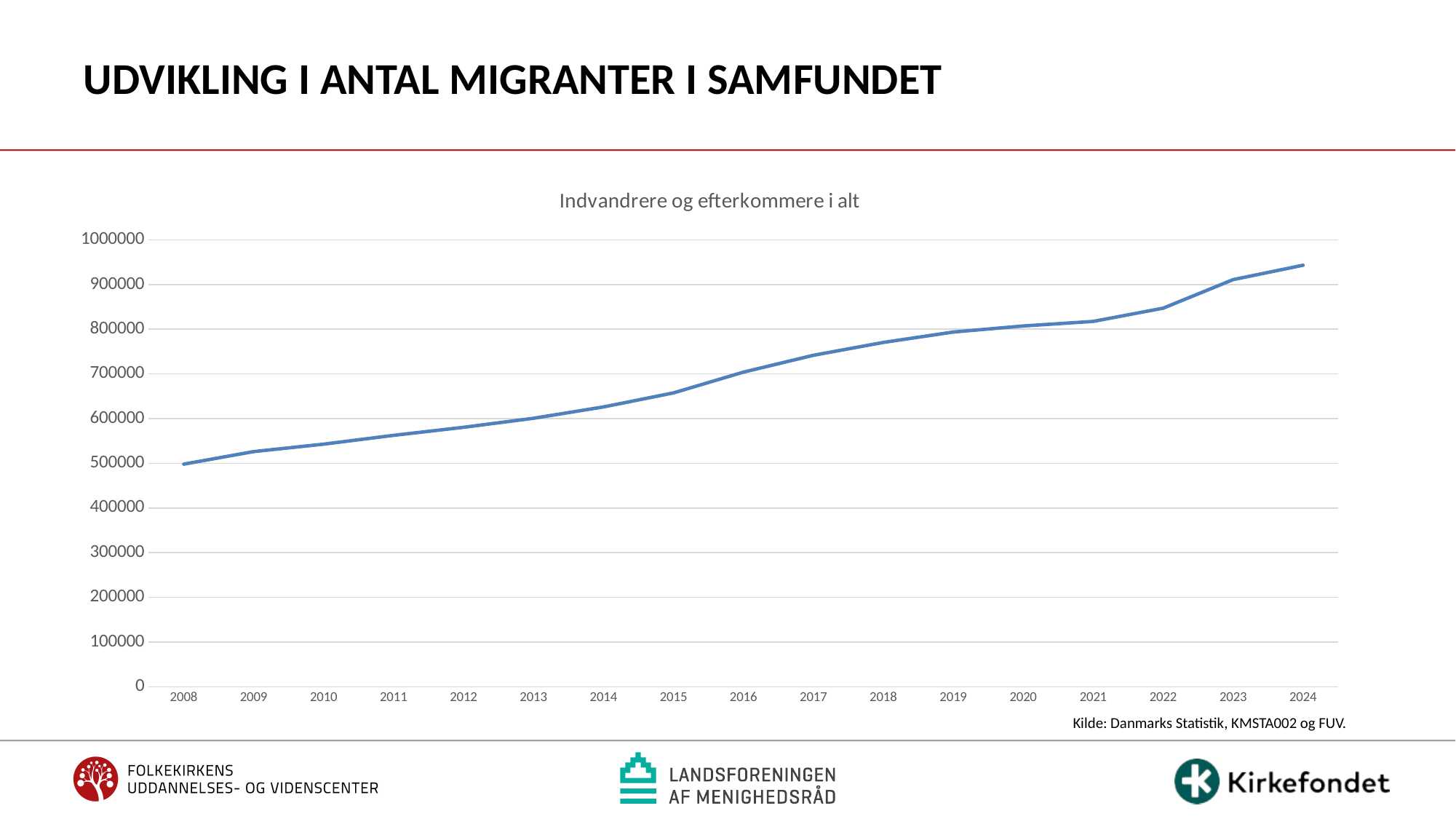
How many years are plotted along the x axis? 17 What is the first year shown on the x axis? 2008 What is the title of the chart? Indvandrere og efterkommere i alt Which is larger, the value for 2020 or the value for 2014? 2020 Is the value for 2012 greater or less than 600000? less Do the values rise or fall from 2008 to 2024? rise Which year has the lowest value? 2008 Is the value for 2008 greater or less than 600000? less What kind of chart is shown on the slide? line chart Is the value for 2024 greater or less than 900000? greater Which year has the highest value? 2024